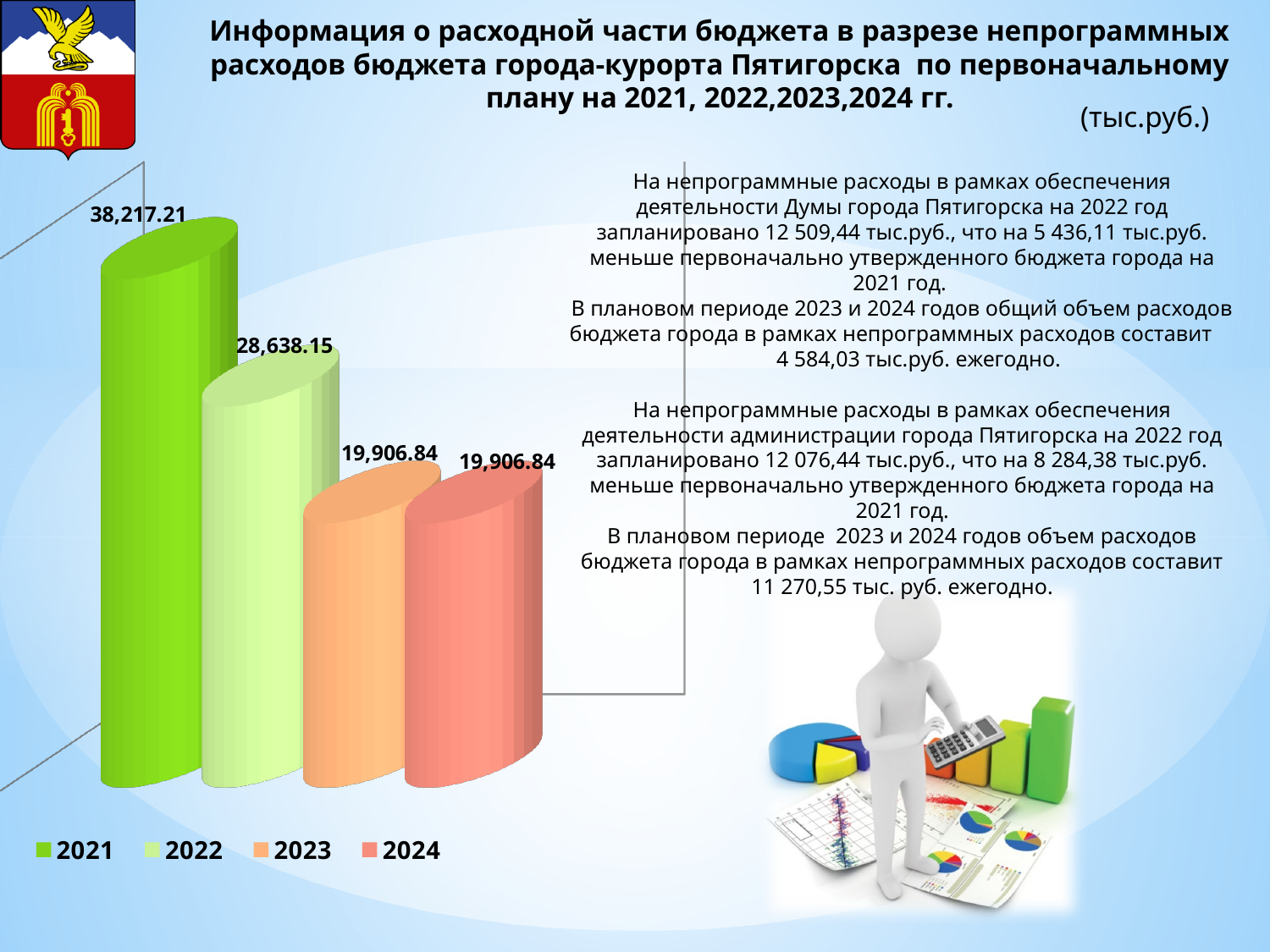
What is the difference between the values for 2021 and 2022? 9,579.06 Which is larger, the value for 2021 or the value for 2022? 2021 What is the value for 2021 on the chart? 38,217.21 What is the difference between the values for 2022 and 2023? 8,731.31 Which year has the highest value on the chart? 2021 How many entries does the chart legend list? 4 What is the difference between the values for 2021 and 2024? 18,310.37 What is the value for 2023 on the chart? 19,906.84 What is the value for 2024 on the chart? 19,906.84 How many bars are shown on the chart? 4 Are the values for 2023 and 2024 the same? Yes What is the value for 2022 on the chart? 28,638.15